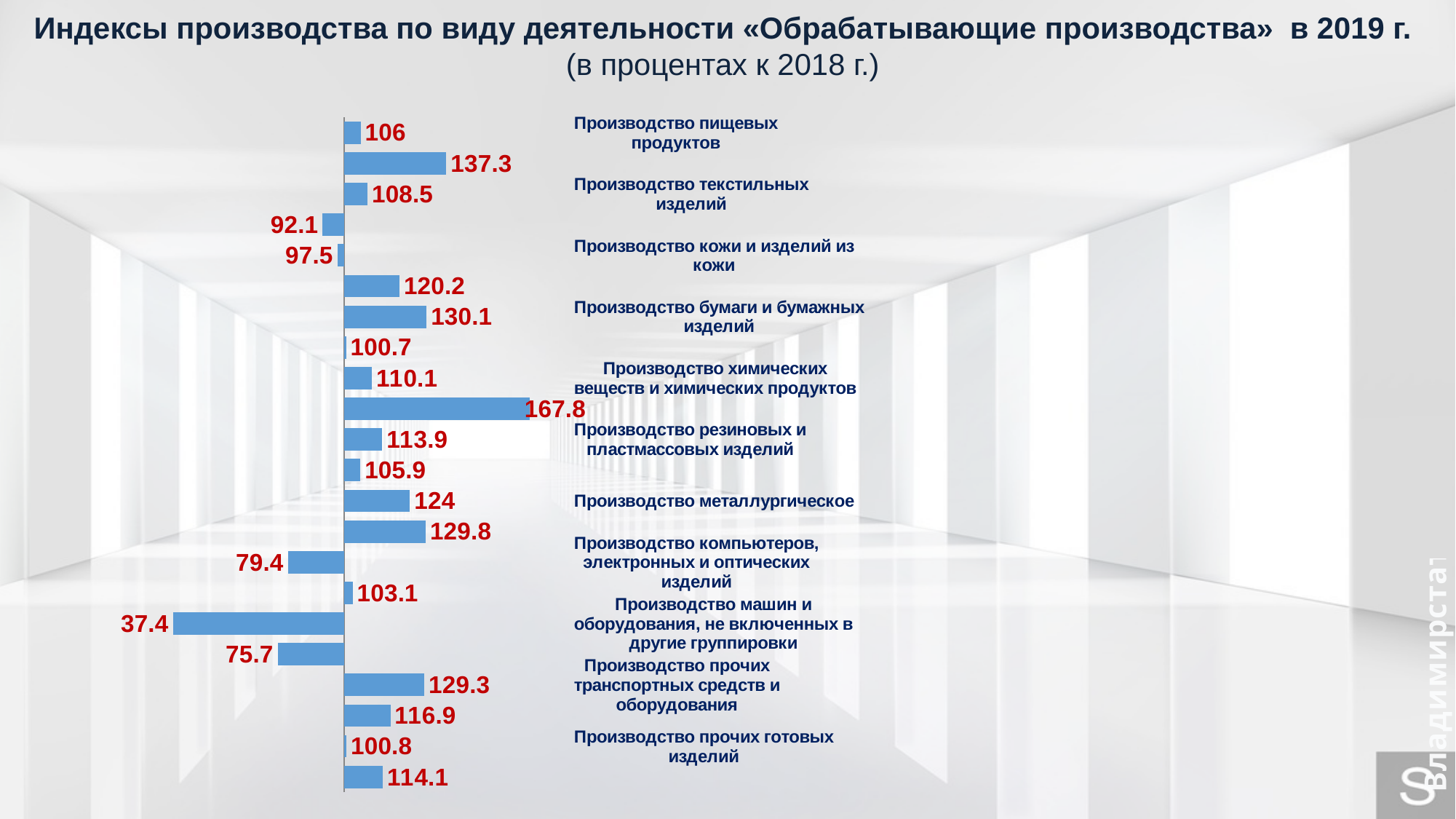
What is the difference between the highest value (167.8) and the lowest value (37.4) in the chart? 130.4 What is the value for «Производство машин и оборудования, не включенных в другие группировки»? 37.4 What is the highest value shown in the chart? 167.8 What is the value for «Производство металлургическое»? 124 How many bars are plotted in the chart? 22 What type of chart is shown on the slide? bar chart What colour are the bars in the chart? blue Which is larger, the bar labelled 137.3 or the bar labelled 130.1? 137.3 What year do the production indices in the chart refer to, according to the title? 2019 г. What is the lowest value shown in the chart? 37.4 How many bars in the chart have values below 100? 5 What is the value for «Производство пищевых продуктов»? 106